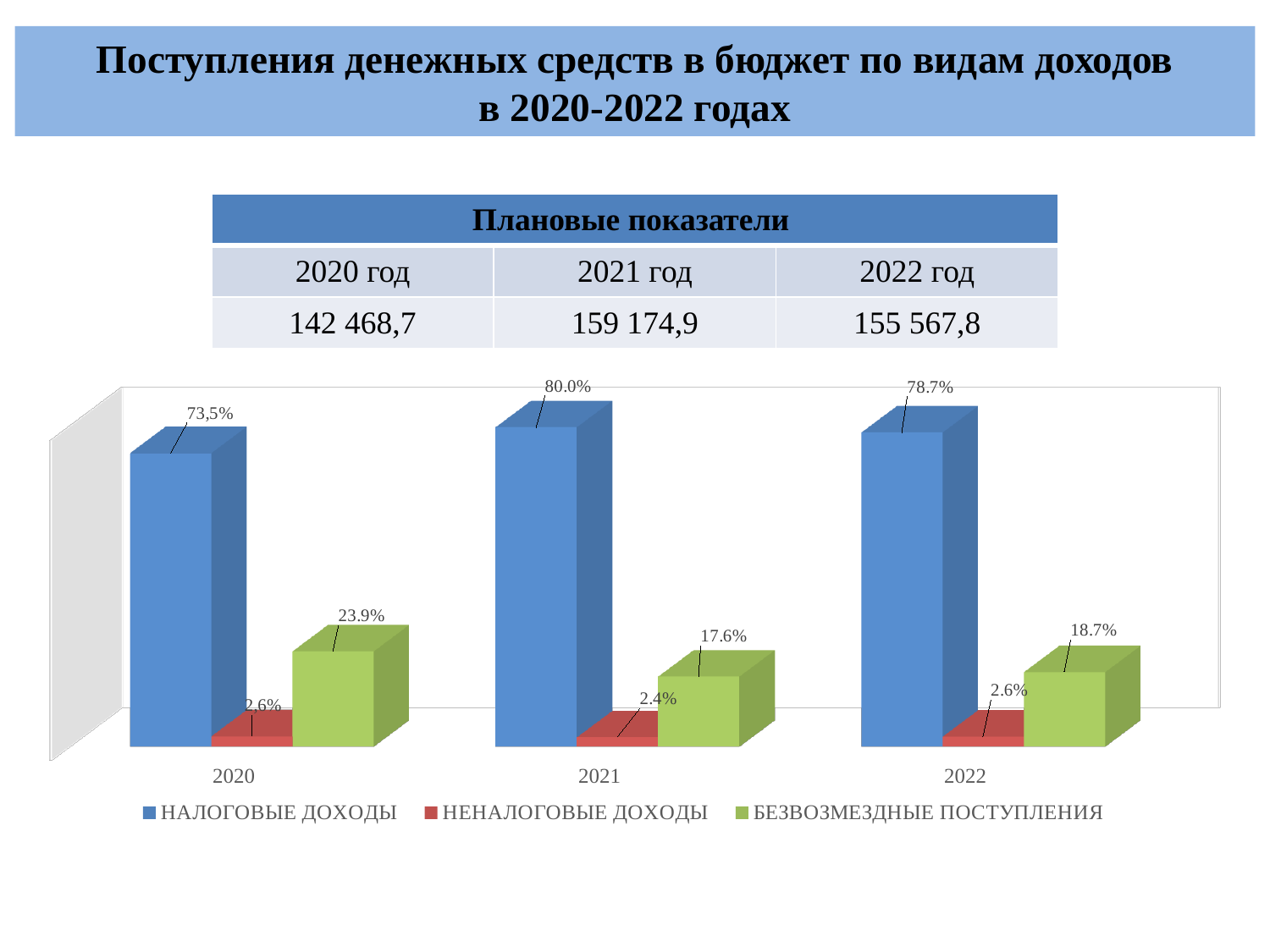
What is the value for НАЛОГОВЫЕ ДОХОДЫ in 2022? 78.7% In which year is the value for НАЛОГОВЫЕ ДОХОДЫ highest? 2021 What is the difference between the БЕЗВОЗМЕЗДНЫЕ ПОСТУПЛЕНИЯ values for 2020 and 2021? 6.3% What kind of chart is shown on the slide? Bar chart How many series does the chart legend list? 3 In which year is the value for БЕЗВОЗМЕЗДНЫЕ ПОСТУПЛЕНИЯ lowest? 2021 How many years are shown on the x axis of the chart? 3 What is the value for НАЛОГОВЫЕ ДОХОДЫ in 2021? 80.0% Does the value for БЕЗВОЗМЕЗДНЫЕ ПОСТУПЛЕНИЯ rise or fall from 2020 to 2021? Fall What is the value for БЕЗВОЗМЕЗДНЫЕ ПОСТУПЛЕНИЯ in 2020? 23.9% What is the value for НЕНАЛОГОВЫЕ ДОХОДЫ in 2021? 2.4% Which is larger: БЕЗВОЗМЕЗДНЫЕ ПОСТУПЛЕНИЯ in 2022 or in 2021? 2022